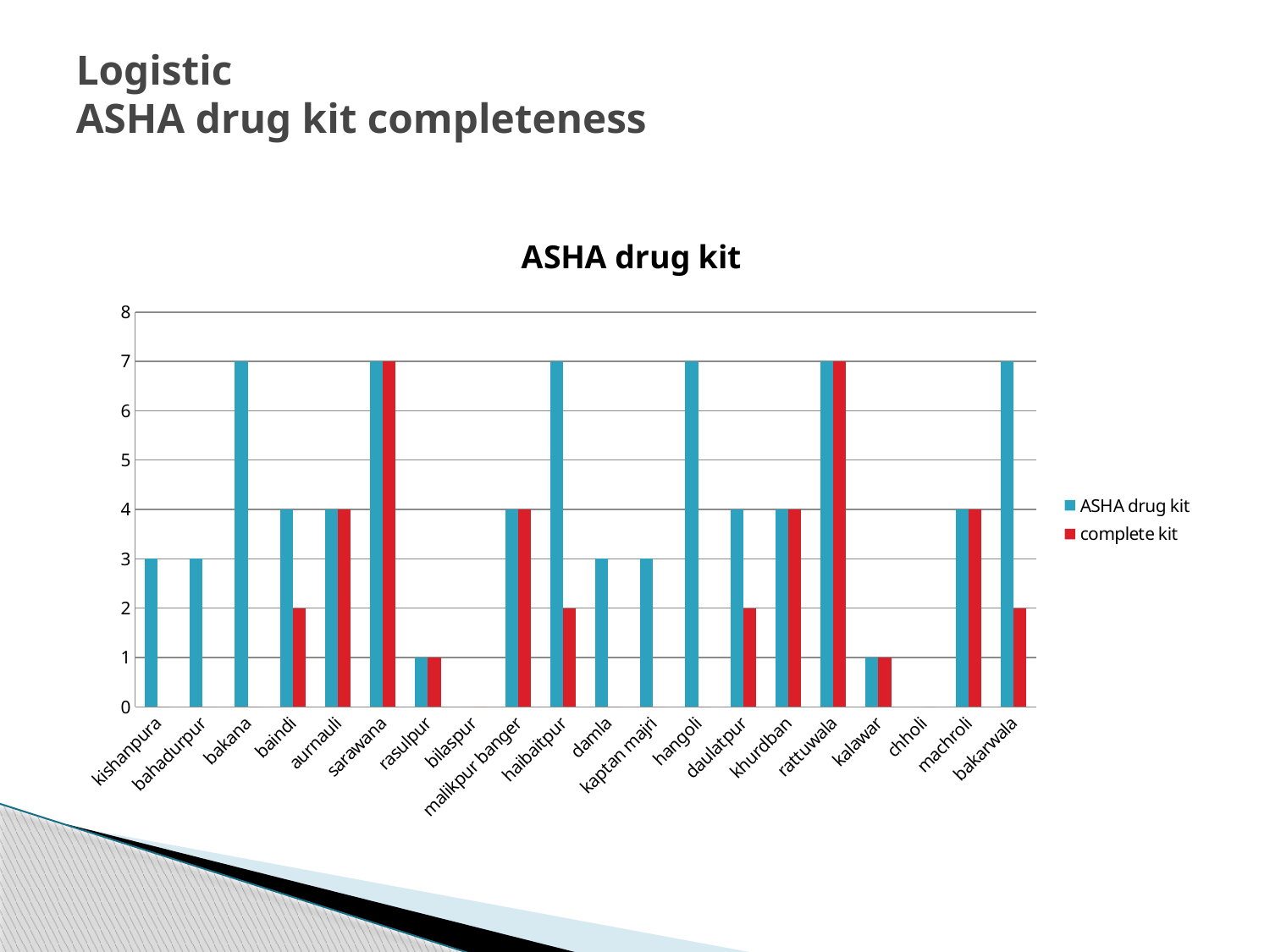
What is the ASHA drug kit value for bakana? 7 Is the ASHA drug kit value for rattuwala greater or less than 5? greater What is the complete kit value for sarawana? 7 How many series does the legend list? 2 What is the ASHA drug kit value for rasulpur? 1 What type of chart is shown on the slide? bar chart What is the difference between the ASHA drug kit value and the complete kit value for bakarwala? 5 How many categories are shown on the x axis? 20 What is the complete kit value for baindi? 2 Which is larger, the ASHA drug kit value for hangoli or the ASHA drug kit value for damla? hangoli What is the difference between the ASHA drug kit value and the complete kit value for haibaitpur? 5 What is the title of the chart? ASHA drug kit